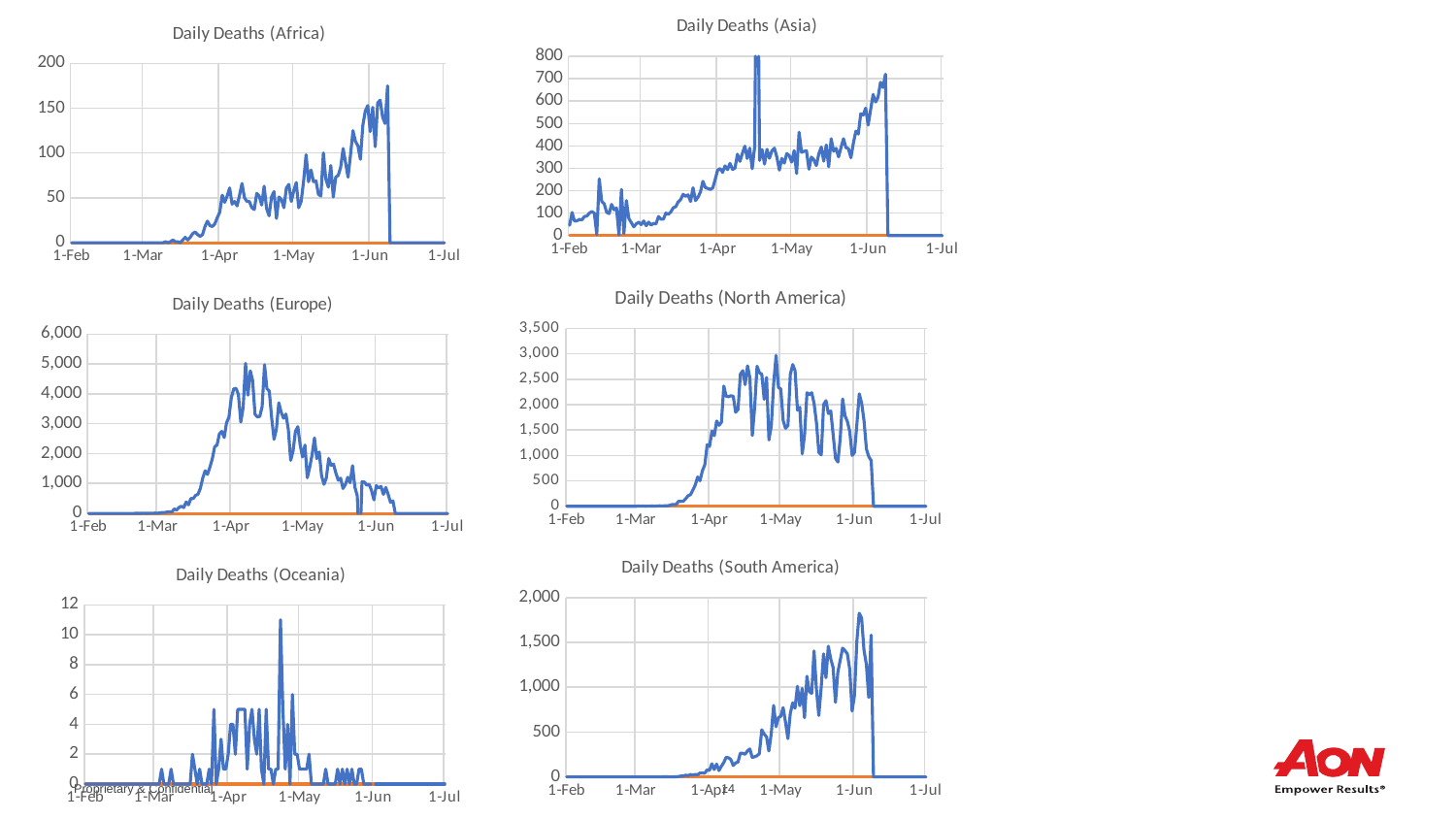
In the 'Daily Deaths (Europe)' chart, do the values generally rise or fall between 1-Apr and 1-Jun? fall Which chart shows a higher peak daily deaths value, 'Daily Deaths (Europe)' or 'Daily Deaths (North America)'? Daily Deaths (Europe) In the 'Daily Deaths (Oceania)' chart, is the peak value greater or less than 8? greater How many charts are shown on the slide? 6 In the 'Daily Deaths (South America)' chart, is the peak value greater or less than 1,500? greater In the 'Daily Deaths (Africa)' chart, is the peak value greater or less than 150? greater In the 'Daily Deaths (South America)' chart, do the values generally rise or fall between 1-Apr and 1-Jun? rise What is the highest value shown on the y axis of the 'Daily Deaths (North America)' chart? 3,500 What kind of chart is 'Daily Deaths (Africa)'? line chart